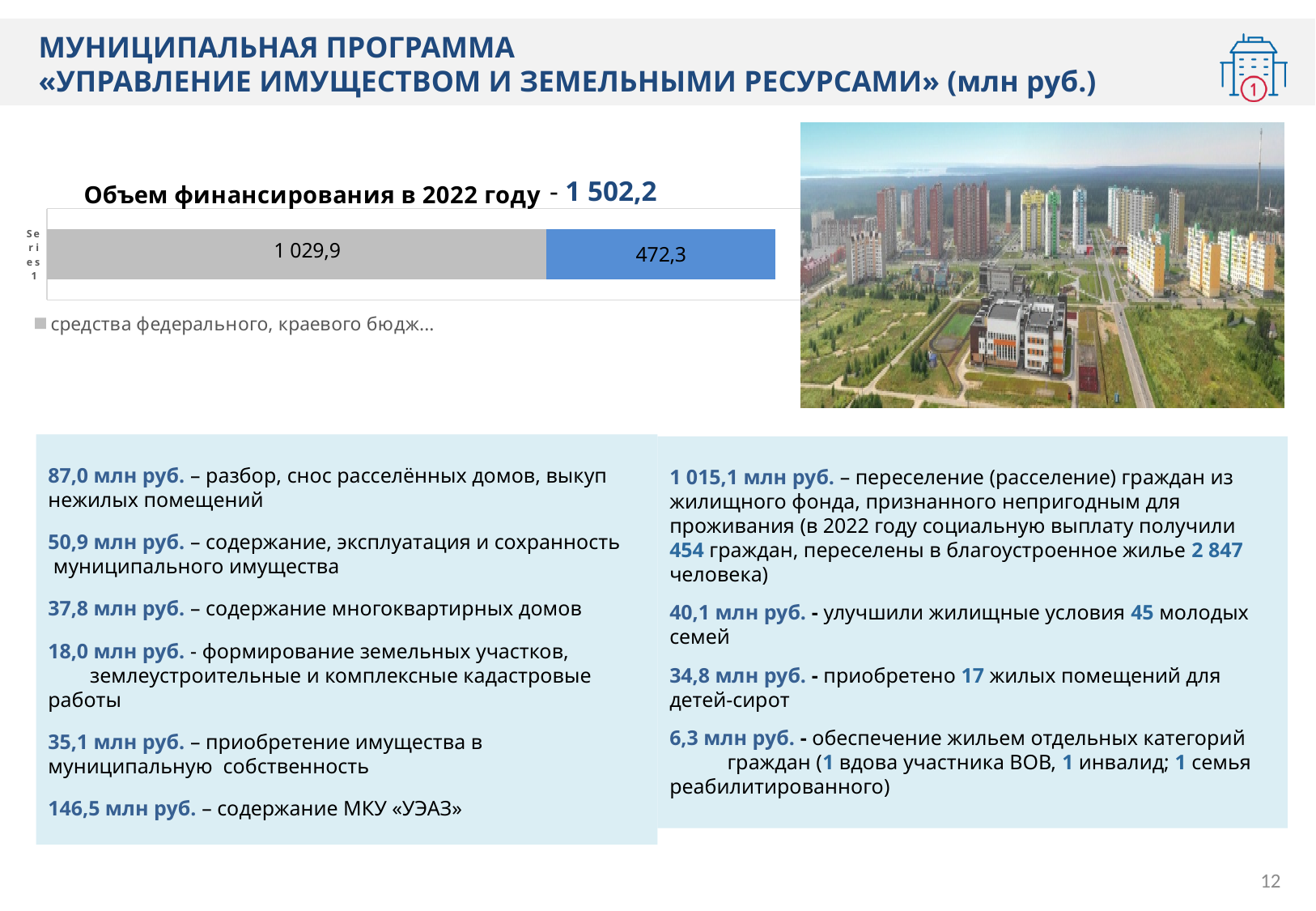
What is the title of the chart? Объем финансирования в 2022 году How many segments make up the stacked bar in the chart? 2 What is the total of the stacked bar in the chart? 1 502,2 What is the value of the gray segment (средства федерального, краевого бюдж…) in the bar chart? 1 029,9 What type of chart is shown on the slide? bar chart Which segment of the bar has the smallest value? the blue segment (472,3) What colour is the segment with the value 472,3? blue Which segment of the bar is larger, the gray one or the blue one? the gray one (1 029,9) What is the value of the blue segment in the bar chart? 472,3 What is the difference between the gray segment (1 029,9) and the blue segment (472,3) in the bar chart? 557,6